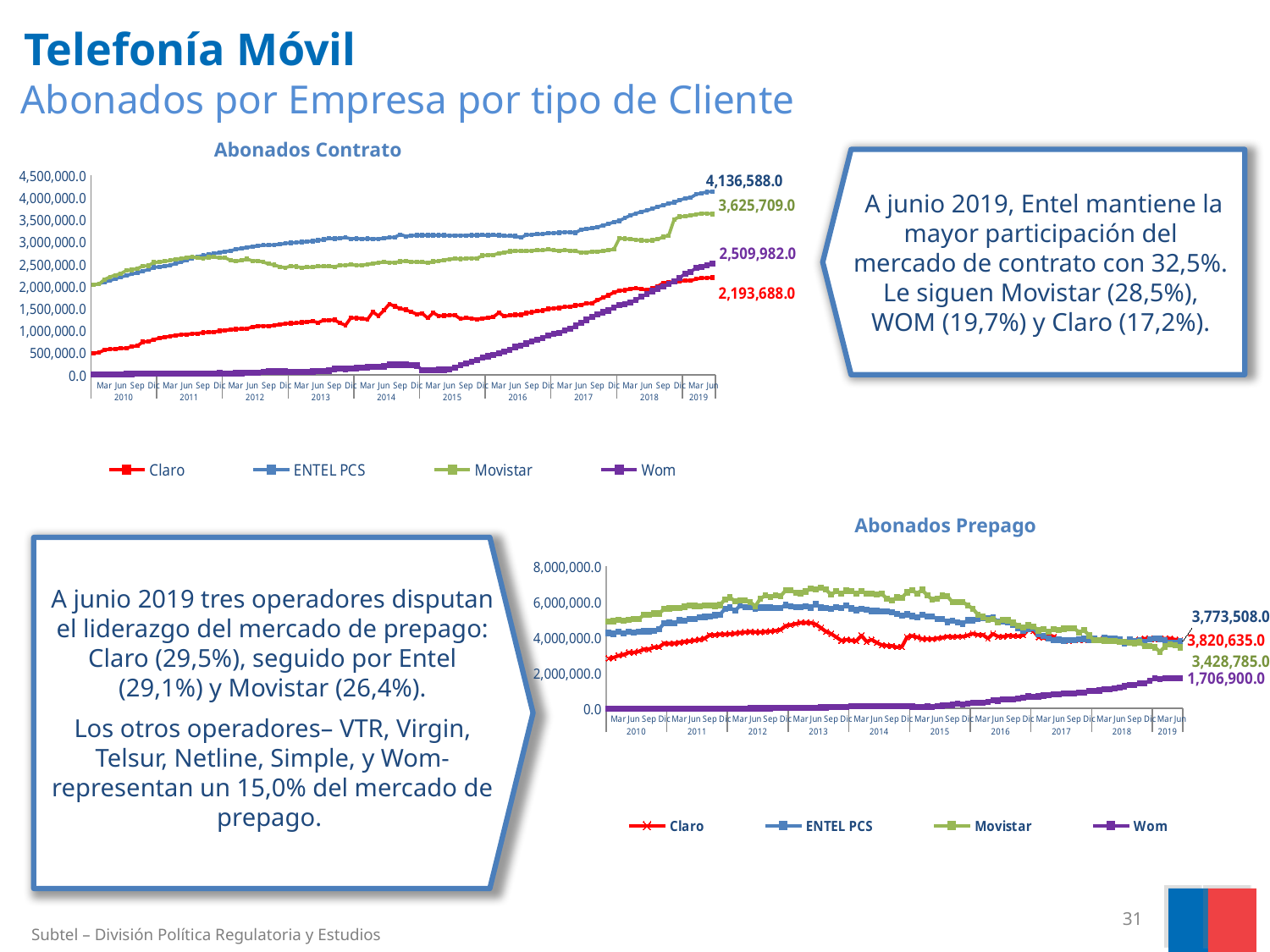
In the "Abonados Prepago" chart, what is the final labelled value for Wom? 1,706,900.0 In the "Abonados Contrato" chart, what is the final labelled value for Wom? 2,509,982.0 In the "Abonados Contrato" chart, is the value for Claro at the start of 2010 greater or less than 1,000,000.0? less In the "Abonados Contrato" chart, what is the final labelled value for ENTEL PCS? 4,136,588.0 In the "Abonados Contrato" chart, which series has the highest value at the end of the period? ENTEL PCS In the "Abonados Prepago" chart, what is the final labelled value for Claro? 3,820,635.0 In the "Abonados Prepago" chart, which has the larger final labelled value, Claro or ENTEL PCS? Claro In the "Abonados Contrato" chart, does the Wom series rise or fall over the period shown? Rise How many series does the legend of the "Abonados Prepago" chart list? 4 In the "Abonados Prepago" chart, which series has the lowest value at the end of the period? Wom In the "Abonados Contrato" chart, what is the difference between the final labelled values of ENTEL PCS and Movistar? 510,879.0 What type of chart is the "Abonados Contrato" chart? Line chart